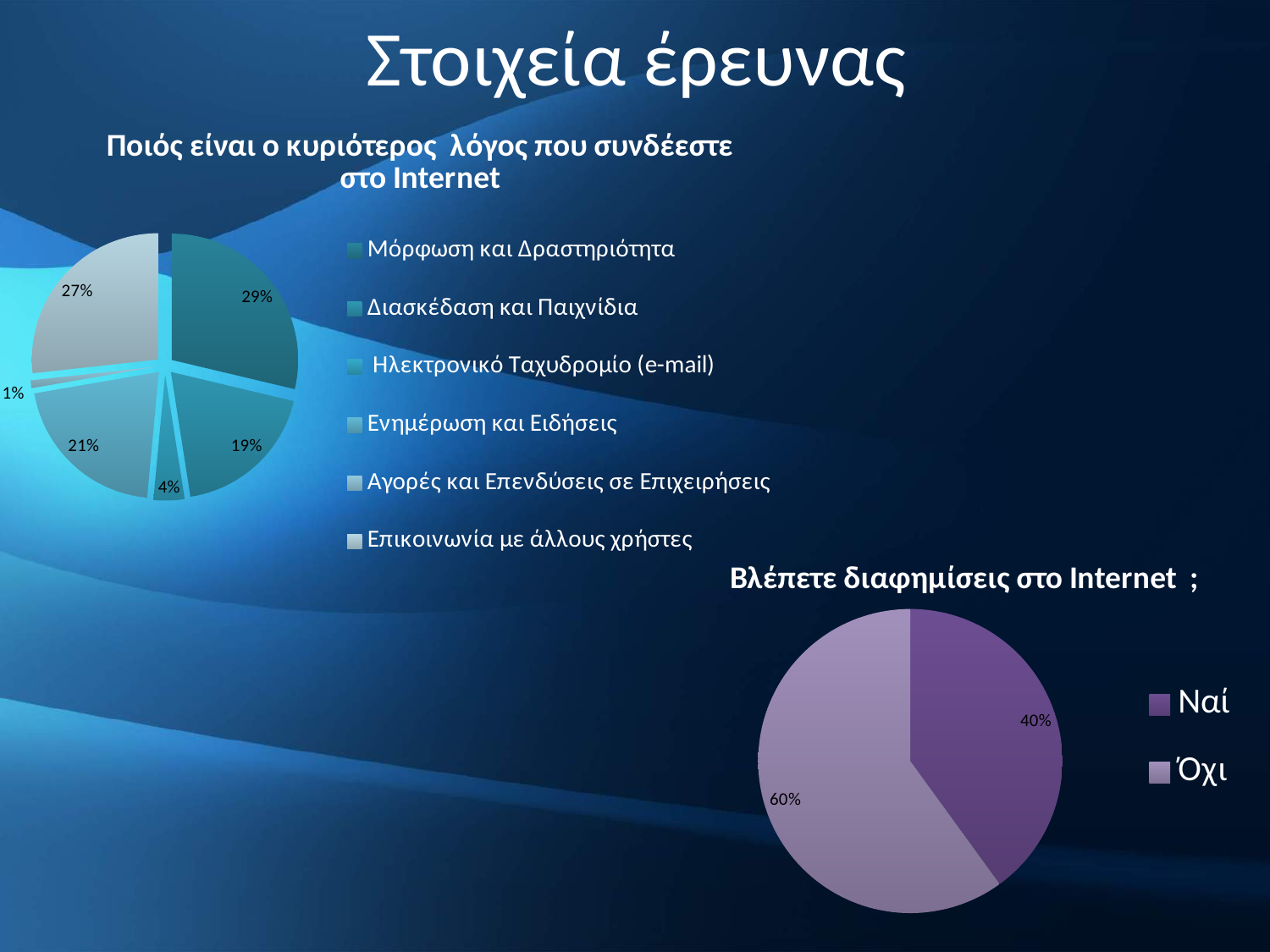
What kind of chart is used for 'Ποιός είναι ο κυριότερος λόγος που συνδέεστε στο Internet'? pie chart How many slices does the pie chart 'Ποιός είναι ο κυριότερος λόγος που συνδέεστε στο Internet' have? 6 In the chart 'Ποιός είναι ο κυριότερος λόγος που συνδέεστε στο Internet', what is the smallest slice's share? 1% In the chart 'Ποιός είναι ο κυριότερος λόγος που συνδέεστε στο Internet', what is the difference between the 29% slice and the 21% slice? 8% In the chart 'Βλέπετε διαφημίσεις στο Internet ;', what share is 'Όχι'? 60% How many entries does the legend of the chart 'Βλέπετε διαφημίσεις στο Internet ;' list? 2 In the chart 'Βλέπετε διαφημίσεις στο Internet ;', what is the difference between the 'Όχι' and 'Ναί' shares? 20% In the chart 'Ποιός είναι ο κυριότερος λόγος που συνδέεστε στο Internet', what is the largest slice's share? 29% How many entries does the legend of the chart 'Ποιός είναι ο κυριότερος λόγος που συνδέεστε στο Internet' list? 6 What kind of chart is used for 'Βλέπετε διαφημίσεις στο Internet ;'? pie chart In the chart 'Βλέπετε διαφημίσεις στο Internet ;', which answer has the larger share? Όχι In the chart 'Βλέπετε διαφημίσεις στο Internet ;', what share is 'Ναί'? 40%